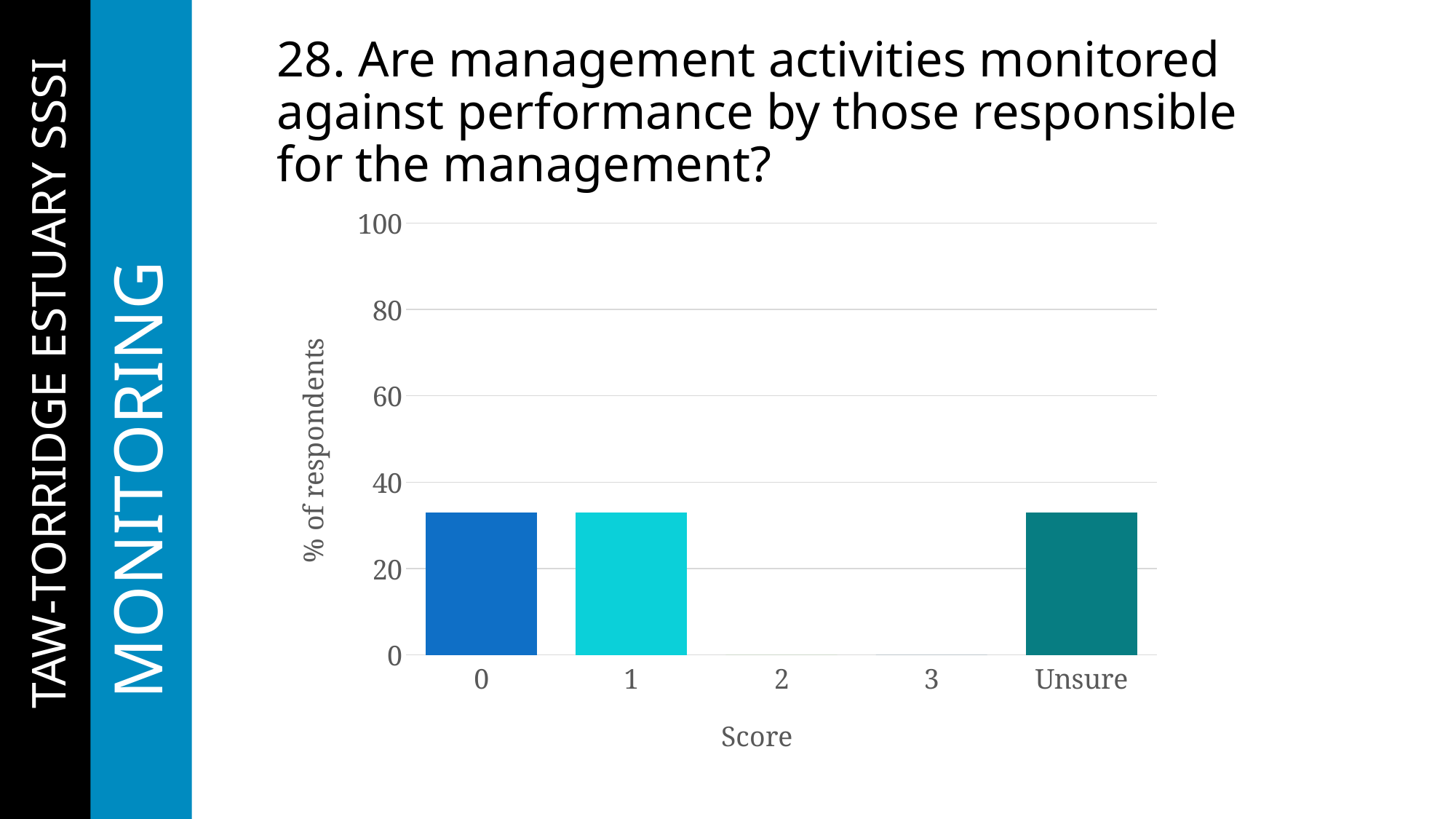
What is the highest value shown on the y axis? 100 Which score categories have no bar (a value of 0)? 2 and 3 What is the label of the y axis? % of respondents What kind of chart is shown on the slide? bar chart Is the value for Unsure greater or less than 40? less How many score categories are shown on the x axis? 5 Which is larger, the value for Unsure or the value for score 3? Unsure Which is larger, the value for score 0 or the value for score 2? score 0 Is the value for score 0 greater or less than 20? greater Is the value for score 0 greater or less than 40? less